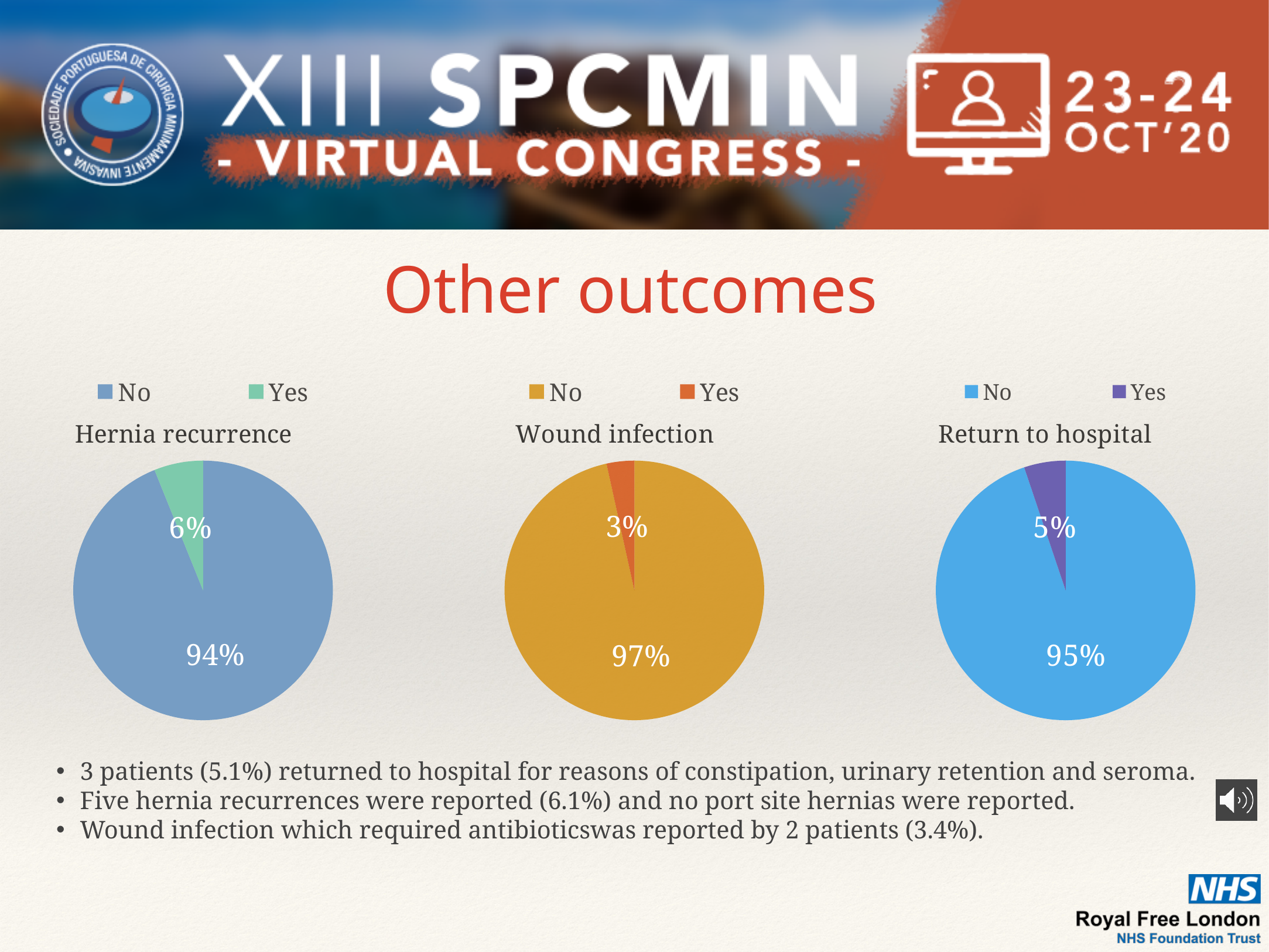
In the 'Wound infection' chart, what percentage is shown for 'No'? 97% In the 'Hernia recurrence' chart, what is the difference between the 'No' and 'Yes' percentages? 88% In the 'Hernia recurrence' chart, what percentage is shown for 'Yes'? 6% In the 'Hernia recurrence' chart, what percentage is shown for 'No'? 94% In the 'Wound infection' chart, what percentage is shown for 'Yes'? 3% What type of chart is the 'Wound infection' chart? pie chart How many entries does the legend of the 'Return to hospital' chart list? 2 In the 'Return to hospital' chart, which slice is the smallest? Yes In the 'Return to hospital' chart, what percentage is shown for 'Yes'? 5% Is the 'Yes' share in the 'Hernia recurrence' chart larger or smaller than the 'Yes' share in the 'Wound infection' chart? larger In the 'Wound infection' chart, which slice is the largest? No In the 'Return to hospital' chart, what percentage is shown for 'No'? 95%